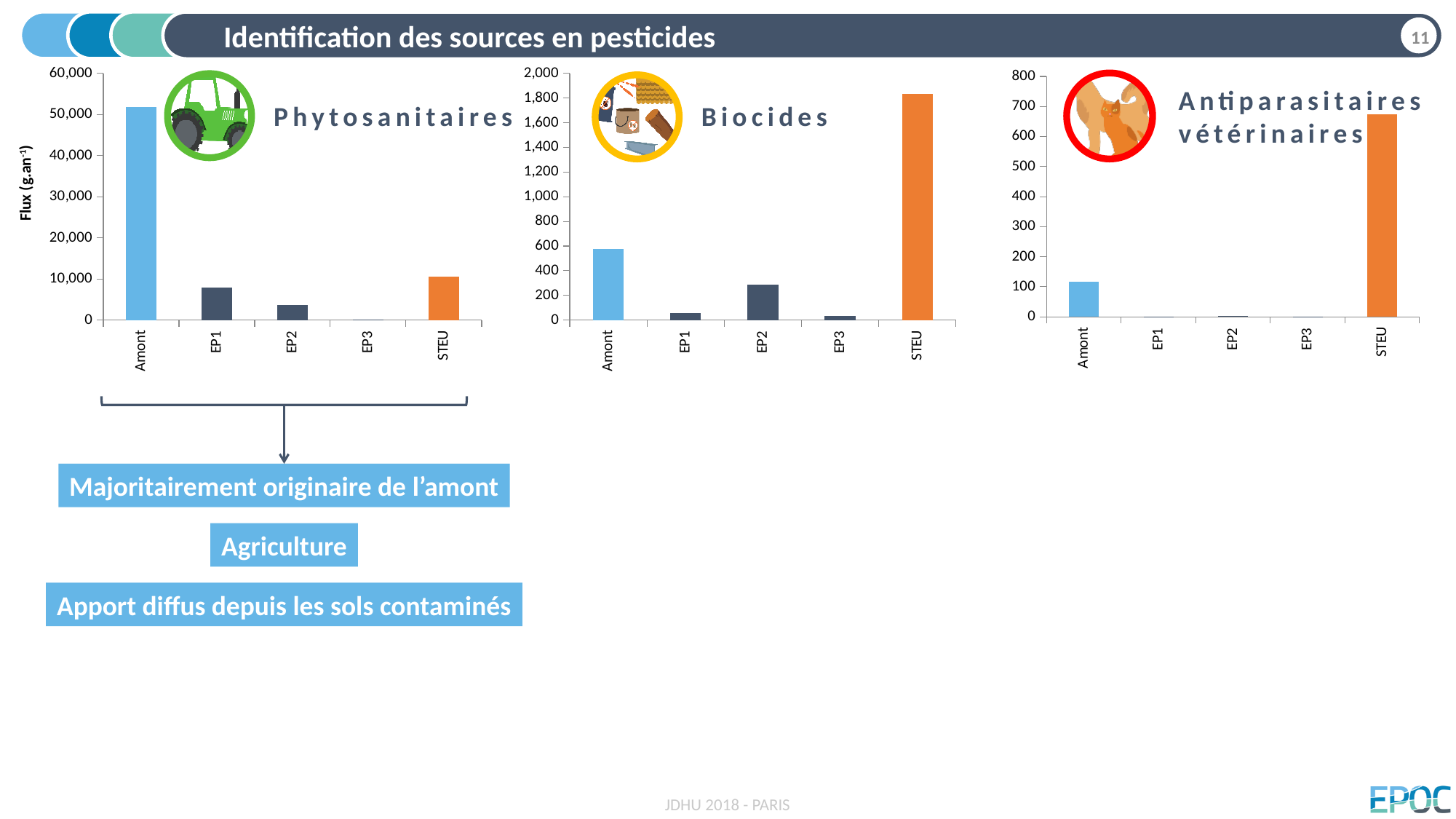
In the Phytosanitaires chart, which category has the highest flux? Amont In the Phytosanitaires chart, which category has the lowest flux? EP3 What kind of chart is the Phytosanitaires chart? bar chart In the Phytosanitaires chart, which is larger, the value for EP1 or the value for STEU? STEU How many categories are shown on the x axis of the Biocides chart? 5 In the Biocides chart, is the value for STEU greater or less than 1,600? greater In the Biocides chart, which category has the highest flux? STEU What is the y-axis label of the Phytosanitaires chart? Flux (g.an-1) In the Antiparasitaires vétérinaires chart, which category has the highest flux? STEU In the Biocides chart, which is larger, the value for EP1 or the value for EP2? EP2 In the Phytosanitaires chart, is the value for Amont greater or less than 40,000? greater In the Antiparasitaires vétérinaires chart, is the value for STEU greater or less than 600? greater